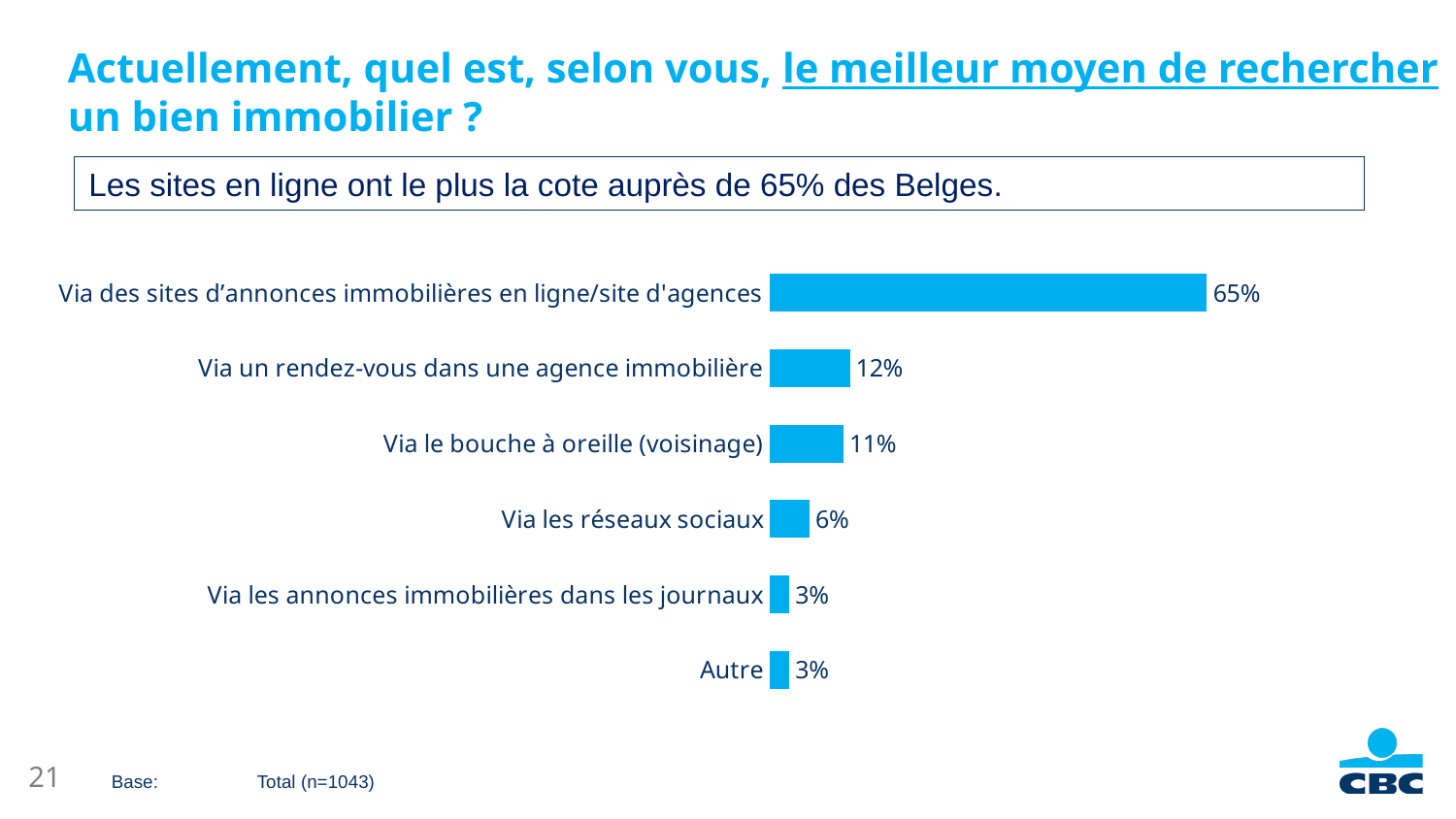
How many categories are shown in the chart? 6 What is the value for "Via des sites d’annonces immobilières en ligne/site d'agences"? 65% What is the difference between the values for "Via les réseaux sociaux" and "Autre"? 3% What kind of chart is shown on the slide? Bar chart Which is larger: the value for "Via un rendez-vous dans une agence immobilière" or "Via le bouche à oreille (voisinage)"? Via un rendez-vous dans une agence immobilière Which category has the highest value? Via des sites d’annonces immobilières en ligne/site d'agences What is the base (sample size) stated at the bottom of the slide? Total (n=1043) What is the value for "Via un rendez-vous dans une agence immobilière"? 12% What is the value for "Via le bouche à oreille (voisinage)"? 11% What is the value for "Via les annonces immobilières dans les journaux"? 3% What is the difference between the values for "Via des sites d’annonces immobilières en ligne/site d'agences" and "Via un rendez-vous dans une agence immobilière"? 53% What is the value for "Via les réseaux sociaux"? 6%